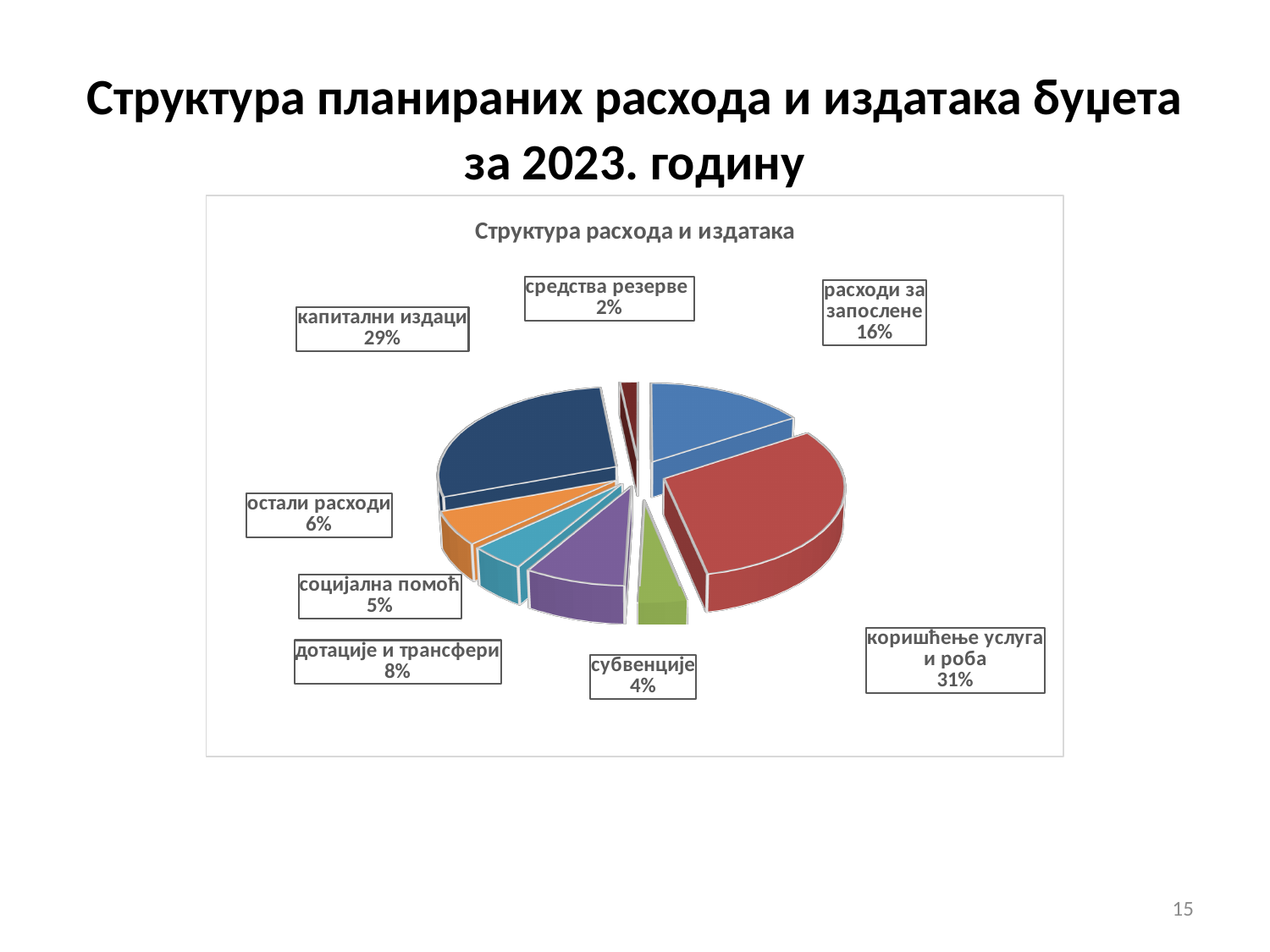
What is the difference between the shares of 'коришћење услуга и роба' and 'капитални издаци'? 2% Which category has the smallest share of the pie? средства резерве Which category has the largest share of the pie? коришћење услуга и роба What share of the pie is labelled 'коришћење услуга и роба'? 31% Which is larger, 'остали расходи' or 'социјална помоћ'? остали расходи What is the title of the chart? Структура расхода и издатака What is the value shown for 'расходи за запослене'? 16% How many slices does the pie chart have? 8 What type of chart is shown on the slide? Pie chart What is the value shown for 'средства резерве'? 2% What share of the pie is labelled 'капитални издаци'? 29% What is the value shown for 'дотације и трансфери'? 8%